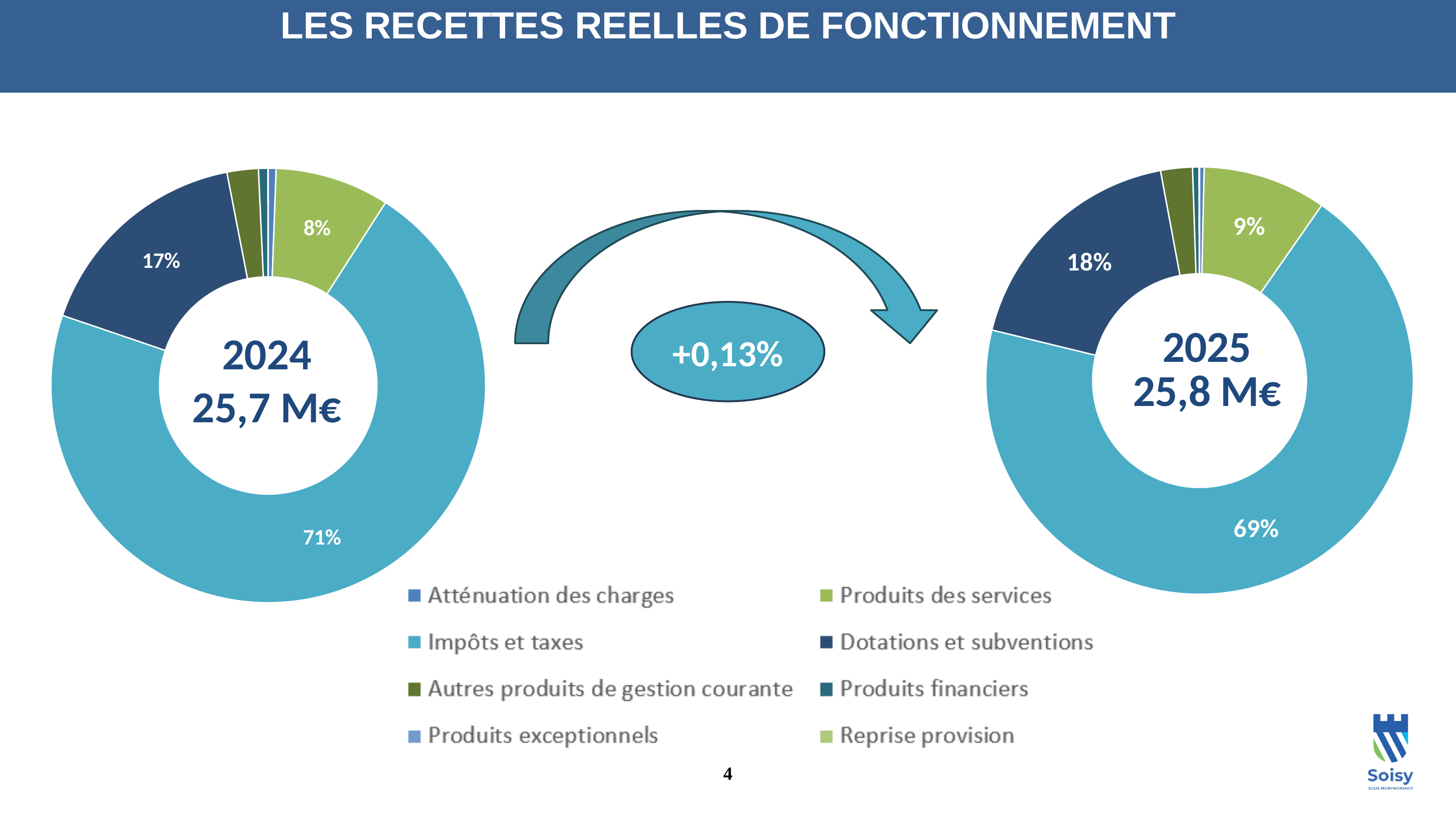
What kind of chart is used for the 2024 data on the slide? Donut (pie) chart In the 2025 chart, what share is labelled for Produits des services? 9% In the 2024 chart, what is the difference between the Impôts et taxes share and the Dotations et subventions share? 54 percentage points Which is larger: the Impôts et taxes share in 2024 or in 2025? 2024 In the 2024 chart, what share is labelled for Produits des services? 8% In the 2025 chart, which category has the largest share? Impôts et taxes How many categories does the legend list? 8 In the 2025 chart, what share is labelled for Dotations et subventions? 18% What total amount is shown in the centre of the 2025 chart? 25,8 M€ In the 2025 chart, what share of revenue comes from Impôts et taxes? 69% In the 2024 chart, what share of revenue comes from Impôts et taxes? 71% In the 2024 chart, what share is labelled for Dotations et subventions? 17%